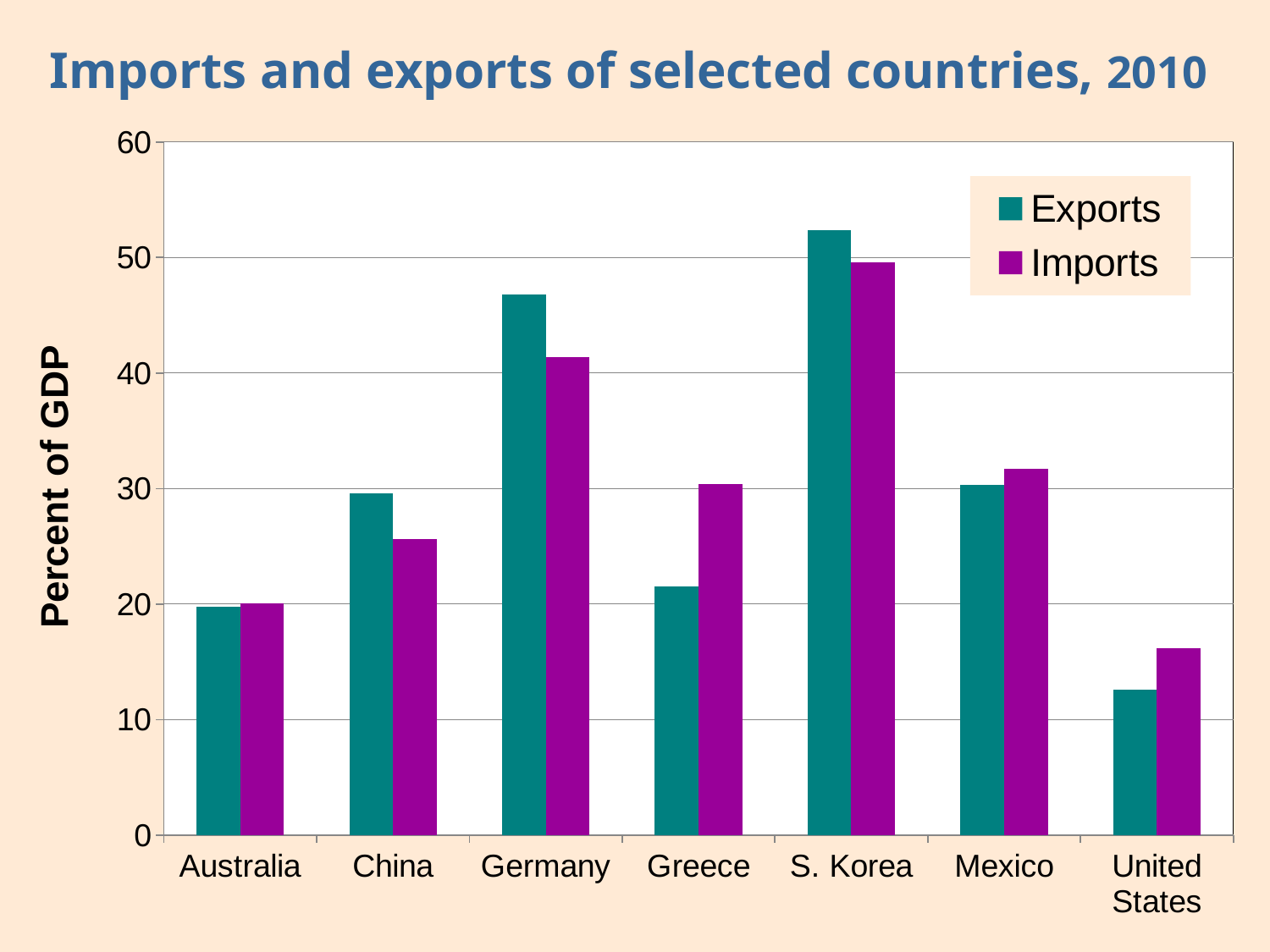
What kind of chart is shown on the slide? bar chart What is the label on the vertical axis? Percent of GDP Which country has the lowest Imports value? United States For Greece, which is larger, Exports or Imports? Imports Is the Exports value for S. Korea greater or less than 50? greater Is the Exports value for Germany greater or less than 40? greater For Germany, which is larger, Exports or Imports? Exports How many series does the legend list? 2 Is the Exports value for the United States greater or less than 20? less Which country has the highest Exports value? S. Korea How many countries are shown on the x axis? 7 Which country has the lowest Exports value? United States